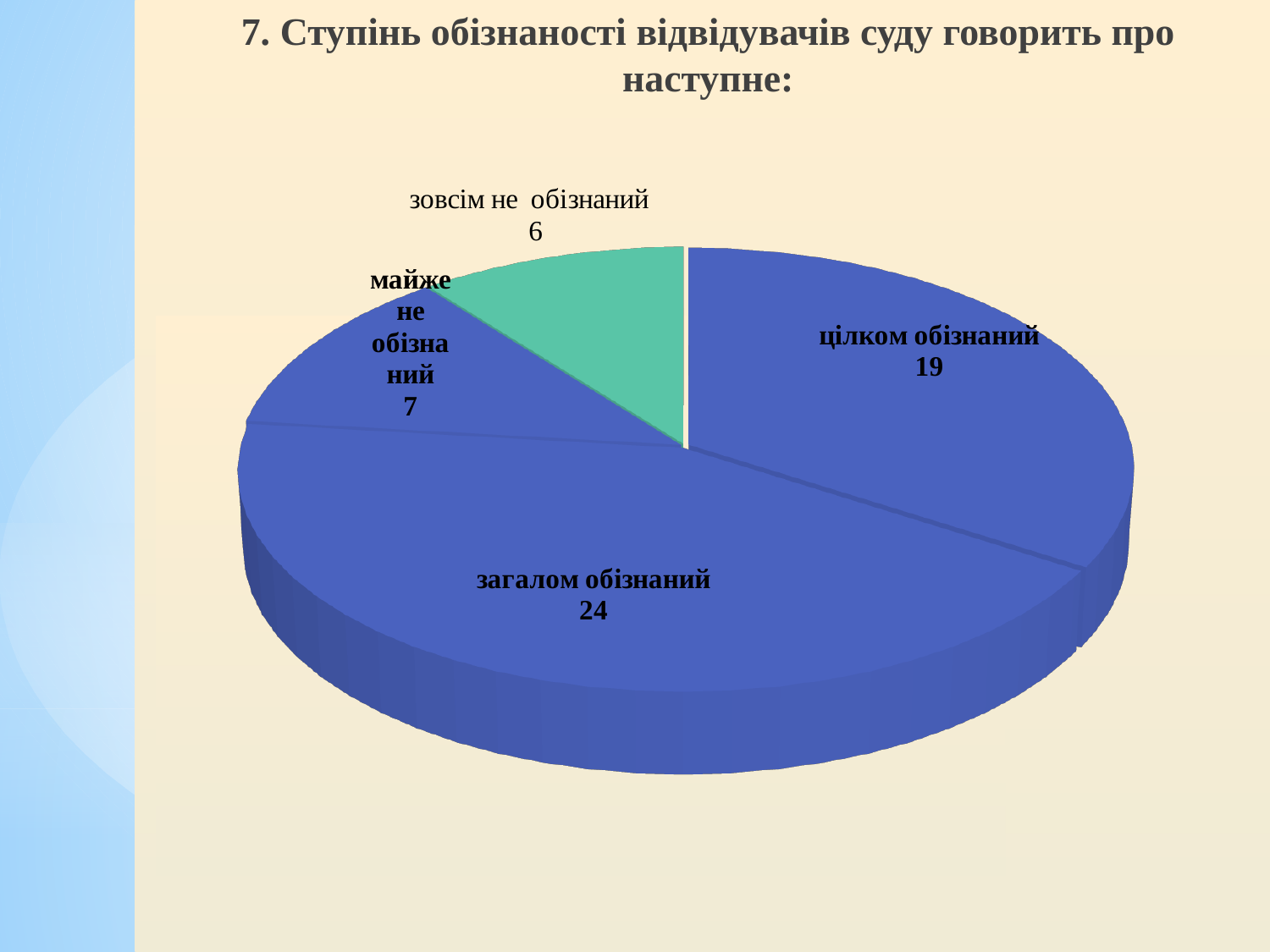
What is the value for "зовсім не обізнаний"? 6 What is the difference between the values for "загалом обізнаний" and "цілком обізнаний"? 5 Which category has the smallest slice? зовсім не обізнаний Which is larger, the value for "цілком обізнаний" or for "майже не обізнаний"? цілком обізнаний Which category has the largest slice? загалом обізнаний What is the value for "майже не обізнаний"? 7 How many slices does the pie chart have? 4 What is the total of all slice values in the pie chart? 56 What is the value for "загалом обізнаний"? 24 What type of chart is shown on the slide? Pie chart What is the value for "цілком обізнаний"? 19 What share of the pie does "майже не обізнаний" represent? 12.5%